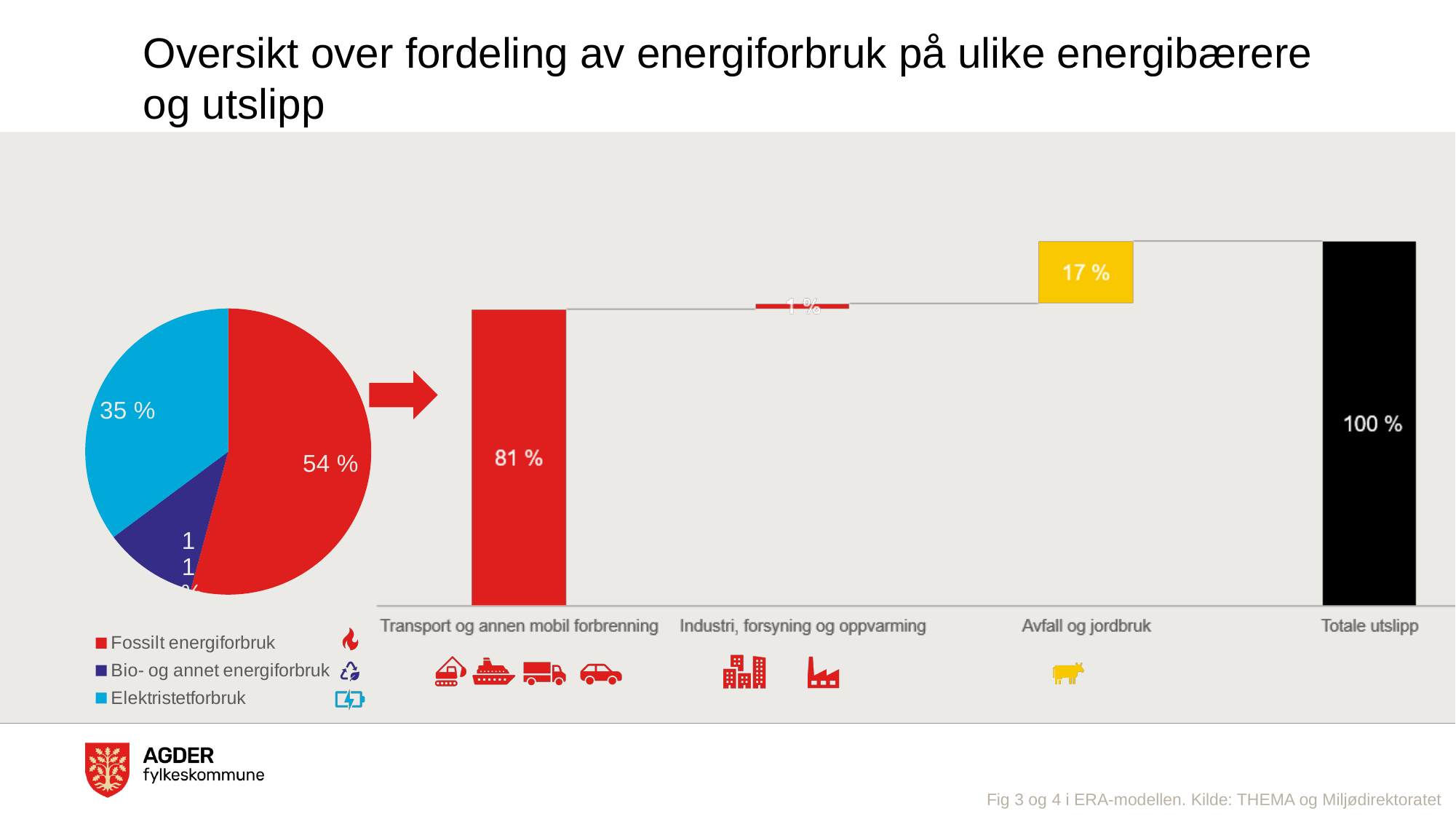
In the pie chart on the left, how many categories does the legend list? 3 In the pie chart on the left, what is the difference between the Fossilt energiforbruk share and the Elektristetforbruk share? 19 % In the bar chart on the right, what value is shown for Transport og annen mobil forbrenning? 81 % In the pie chart on the left, what share is labelled for Elektristetforbruk? 35 % In the pie chart on the left, which category has the largest slice? Fossilt energiforbruk In the pie chart on the left, which category has the smallest slice? Bio- og annet energiforbruk In the bar chart on the right, what value is shown for Totale utslipp? 100 % In the bar chart on the right, which is larger: Transport og annen mobil forbrenning or Avfall og jordbruk? Transport og annen mobil forbrenning In the pie chart on the left, what share is labelled for Fossilt energiforbruk? 54 % In the bar chart on the right, which of the three source categories (excluding Totale utslipp) has the lowest value? Industri, forsyning og oppvarming In the bar chart on the right, what value is shown for Avfall og jordbruk? 17 % What type of chart is the chart on the left of the slide? Pie chart